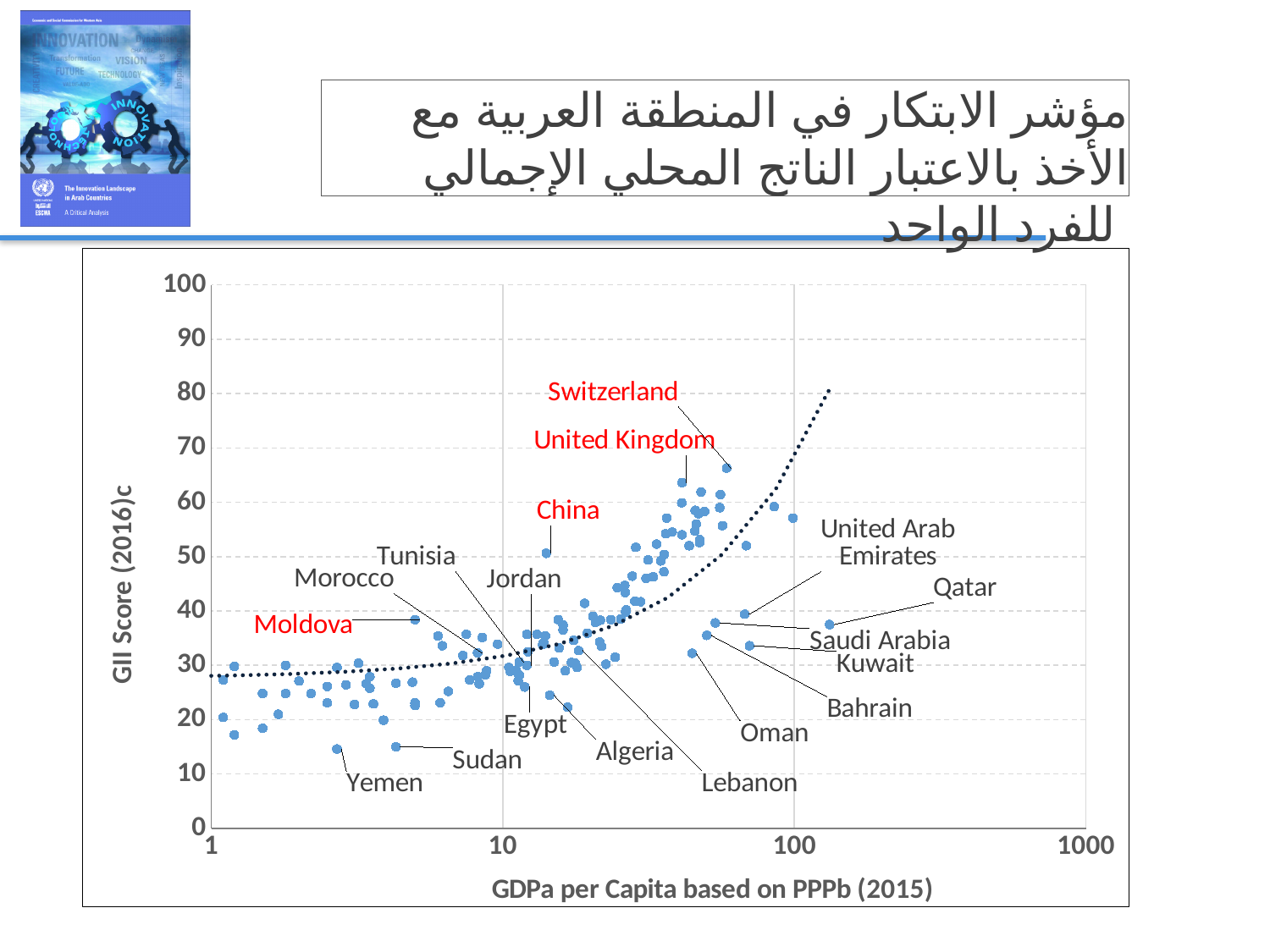
What is the title of the y axis of the chart? GII Score (2016)c Is the GII score for Yemen greater or less than 20? less Is the GDP per capita value for Qatar greater or less than 100? greater What kind of chart is shown on the slide? scatter plot Which has the higher GII score, Switzerland or Qatar? Switzerland What is the title of the x axis of the chart? GDPa per Capita based on PPPb (2015) Is the GII score for Qatar greater or less than 50? less According to the dotted trend line, does the GII score rise or fall as GDP per capita increases? rises Which of the labelled countries has the highest GII score? Switzerland